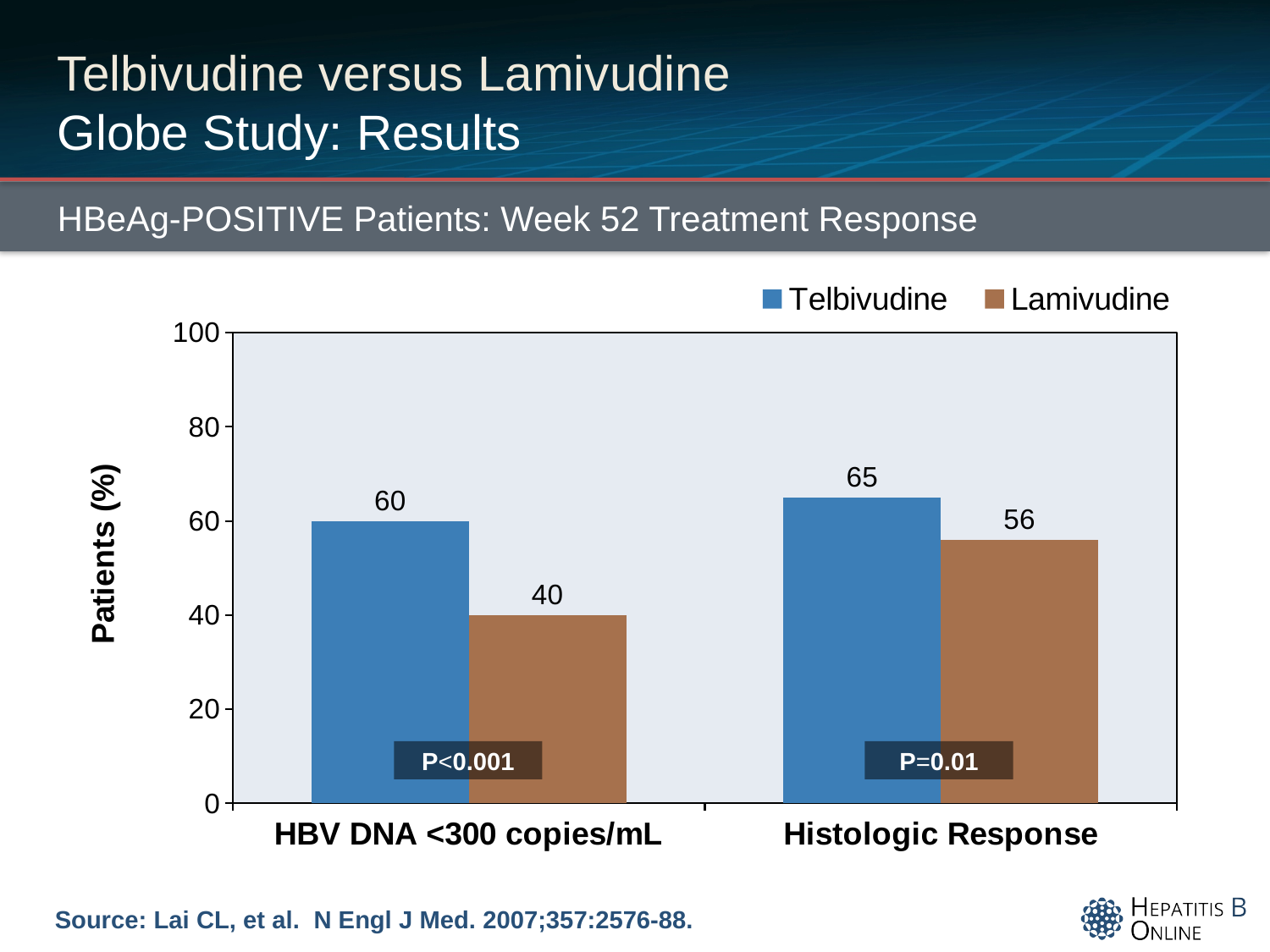
What is the difference between Telbivudine and Lamivudine in the Histologic Response category? 9 What is the value for Lamivudine in the HBV DNA <300 copies/mL category? 40 Which bar has the highest value on the chart? Telbivudine, Histologic Response How many series does the legend list? 2 What is the difference between Telbivudine and Lamivudine in the HBV DNA <300 copies/mL category? 20 What is the value for Telbivudine in the Histologic Response category? 65 What kind of chart is shown on the slide? Bar chart What is the value for Lamivudine in the Histologic Response category? 56 What is the value for Telbivudine in the HBV DNA <300 copies/mL category? 60 How many categories are shown on the x axis? 2 Which bar has the lowest value on the chart? Lamivudine, HBV DNA <300 copies/mL Which is larger in the Histologic Response category, Telbivudine or Lamivudine? Telbivudine